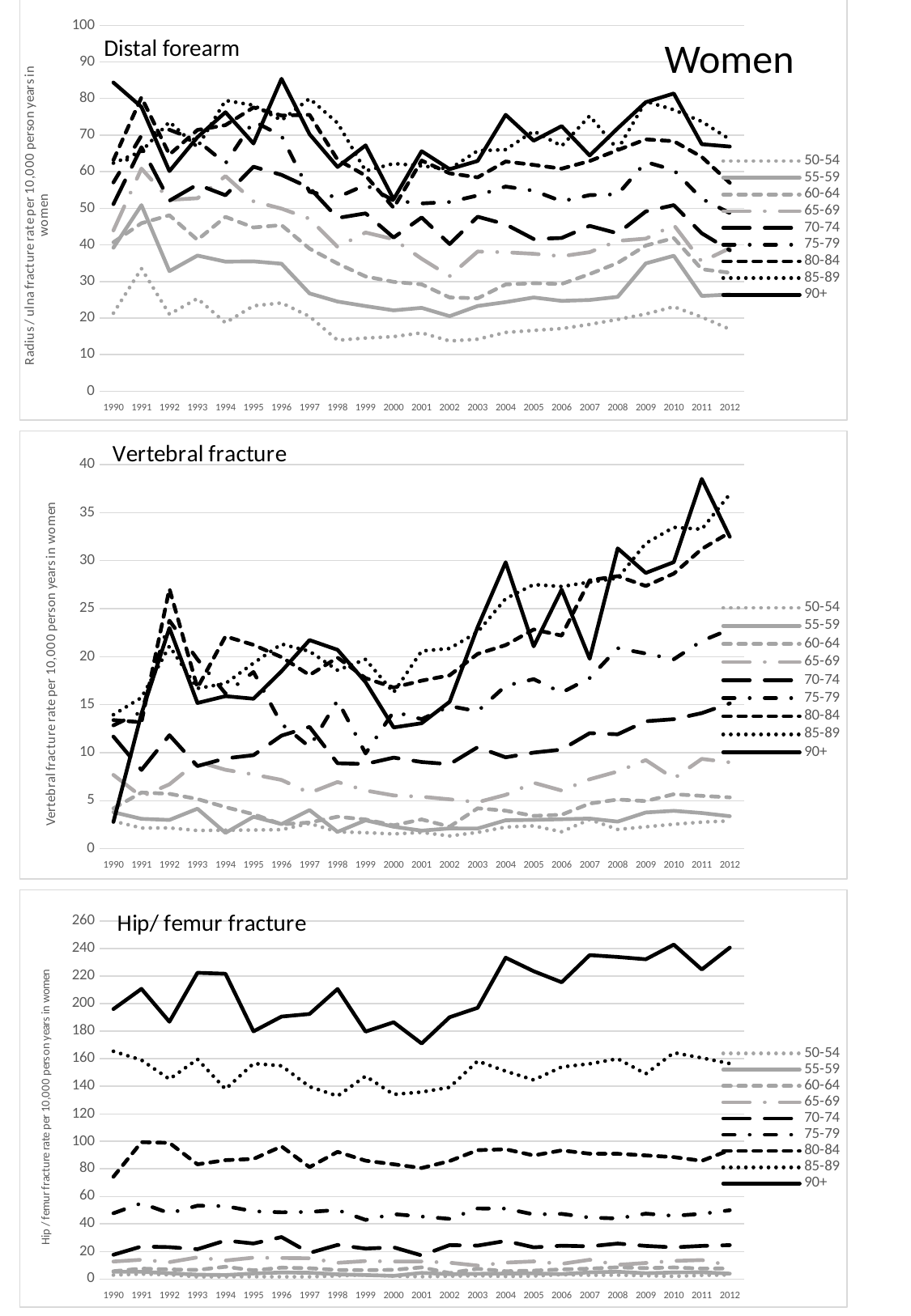
What is the y-axis label of the Hip/ femur fracture chart? Hip / femur fracture rate per 10,000 person years in women In the Distal forearm chart, which age group has the lowest fracture rate in 2012? 50-54 In the Distal forearm chart, is the value for 90+ in 2012 greater or less than 60? greater In the Hip/ femur fracture chart, which age group has the highest fracture rate across the years? 90+ In the Distal forearm chart, does the 55-59 series rise or fall from 1990 to 2012? fall How many series does the legend of the Vertebral fracture chart list? 9 In the Vertebral fracture chart, is the value for 50-54 in 2012 greater or less than 5? less In the Hip/ femur fracture chart, is the value for 90+ in 2001 greater or less than 180? less In the Vertebral fracture chart, does the 90+ series rise or fall from 1990 to 2012? rise What kind of chart is the Distal forearm chart? line chart How many years are shown on the x axis of the Hip/ femur fracture chart? 23